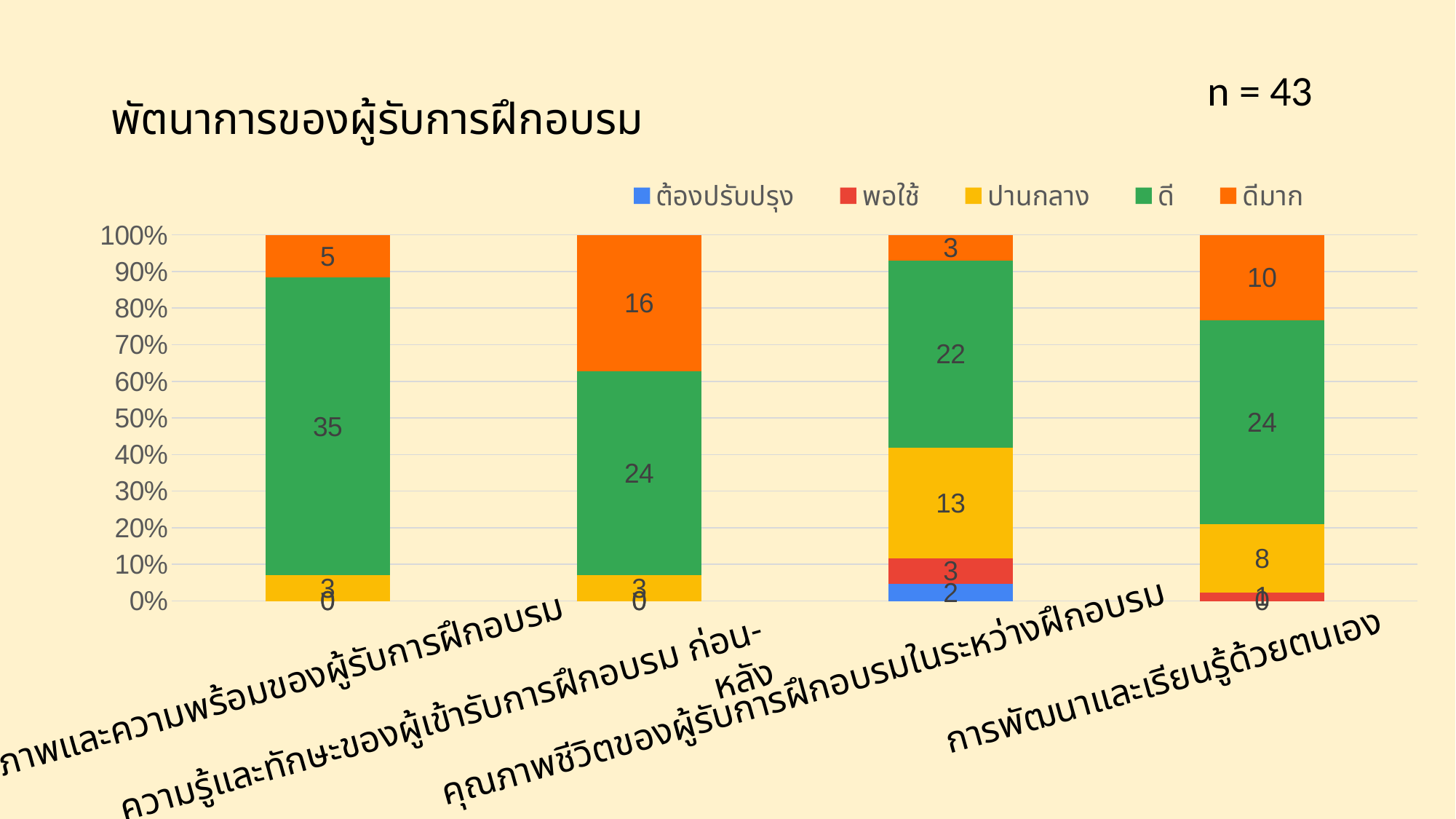
Which category has the highest value for ดีมาก? ความรู้และทักษะของผู้เข้ารับการฝึกอบรม ก่อน-หลัง How many categories (bars) are shown in the chart? 4 What is the value of ดีมาก for การพัฒนาและเรียนรู้ด้วยตนเอง? 10 How many series does the legend list? 5 What is the value of ดี for ความรู้และทักษะของผู้เข้ารับการฝึกอบรม ก่อน-หลัง? 24 Which category has the highest value for ดี? ภาพและความพร้อมของผู้รับการฝึกอบรม What is the difference between the ดีมาก values for ความรู้และทักษะของผู้เข้ารับการฝึกอบรม ก่อน-หลัง and การพัฒนาและเรียนรู้ด้วยตนเอง? 6 What is the value of ต้องปรับปรุง for คุณภาพชีวิตของผู้รับการฝึกอบรมในระหว่างฝึกอบรม? 2 Which is larger: the ปานกลาง value for คุณภาพชีวิตของผู้รับการฝึกอบรมในระหว่างฝึกอบรม or for การพัฒนาและเรียนรู้ด้วยตนเอง? คุณภาพชีวิตของผู้รับการฝึกอบรมในระหว่างฝึกอบรม What is the value of ปานกลาง for คุณภาพชีวิตของผู้รับการฝึกอบรมในระหว่างฝึกอบรม? 13 What is the sample size (n) shown on the slide? n = 43 What type of chart is shown on the slide? Stacked bar chart